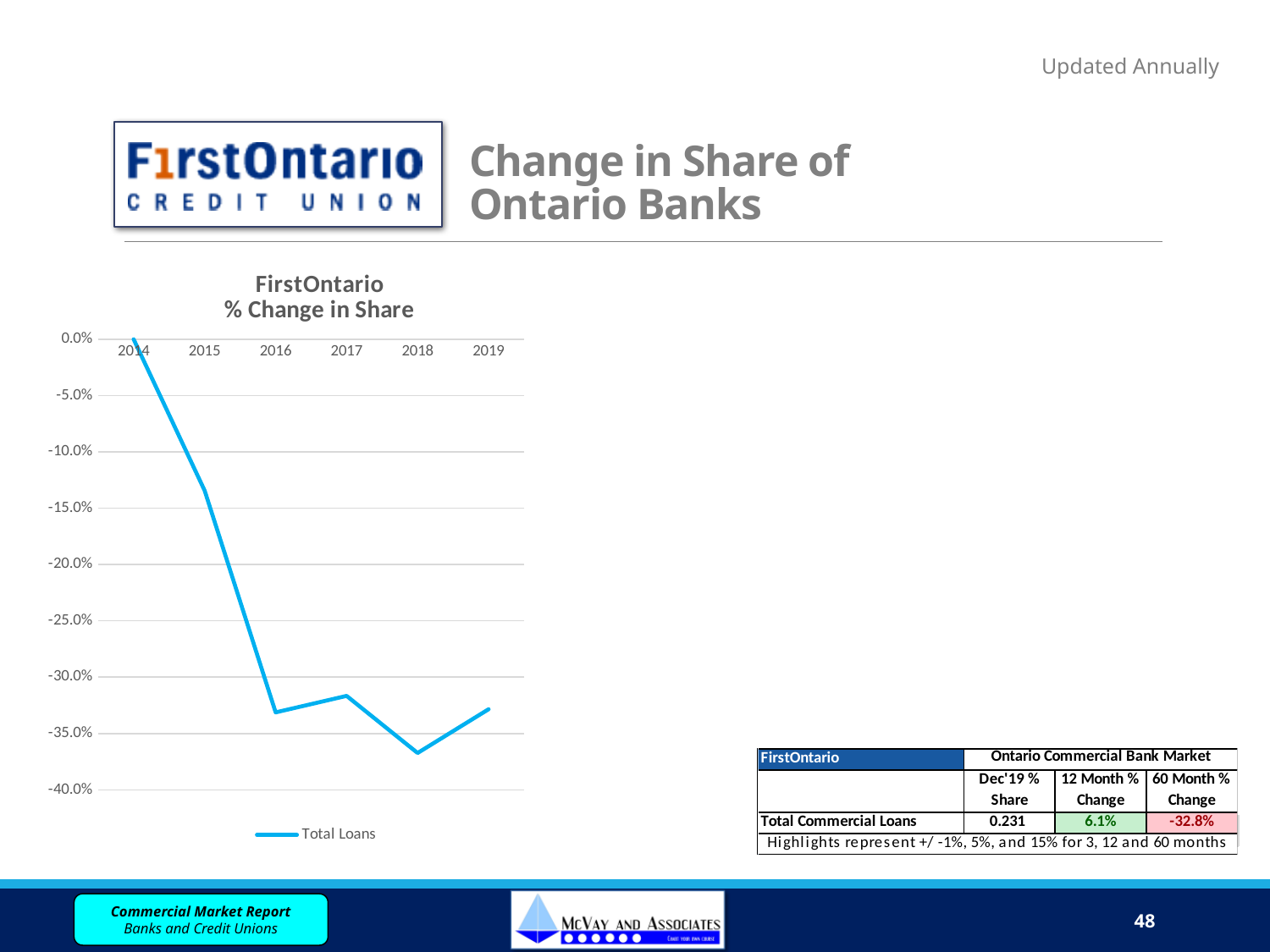
In which year is the Total Loans % change in share the lowest? 2018 How many series does the chart legend list? 1 Is the value for 2017 greater or less than -35.0%? greater Is the value for 2018 greater or less than -35.0%? less How many years are plotted along the x axis of the chart? 6 What kind of chart is shown on the slide? line chart What is the name of the series shown in the chart legend? Total Loans Does the Total Loans line rise or fall from 2014 to 2016? fall What is the title of the chart? FirstOntario % Change in Share Which year has the larger value, 2017 or 2018? 2017 In which year is the Total Loans % change in share the highest? 2014 Is the value for 2015 greater or less than -10.0%? less